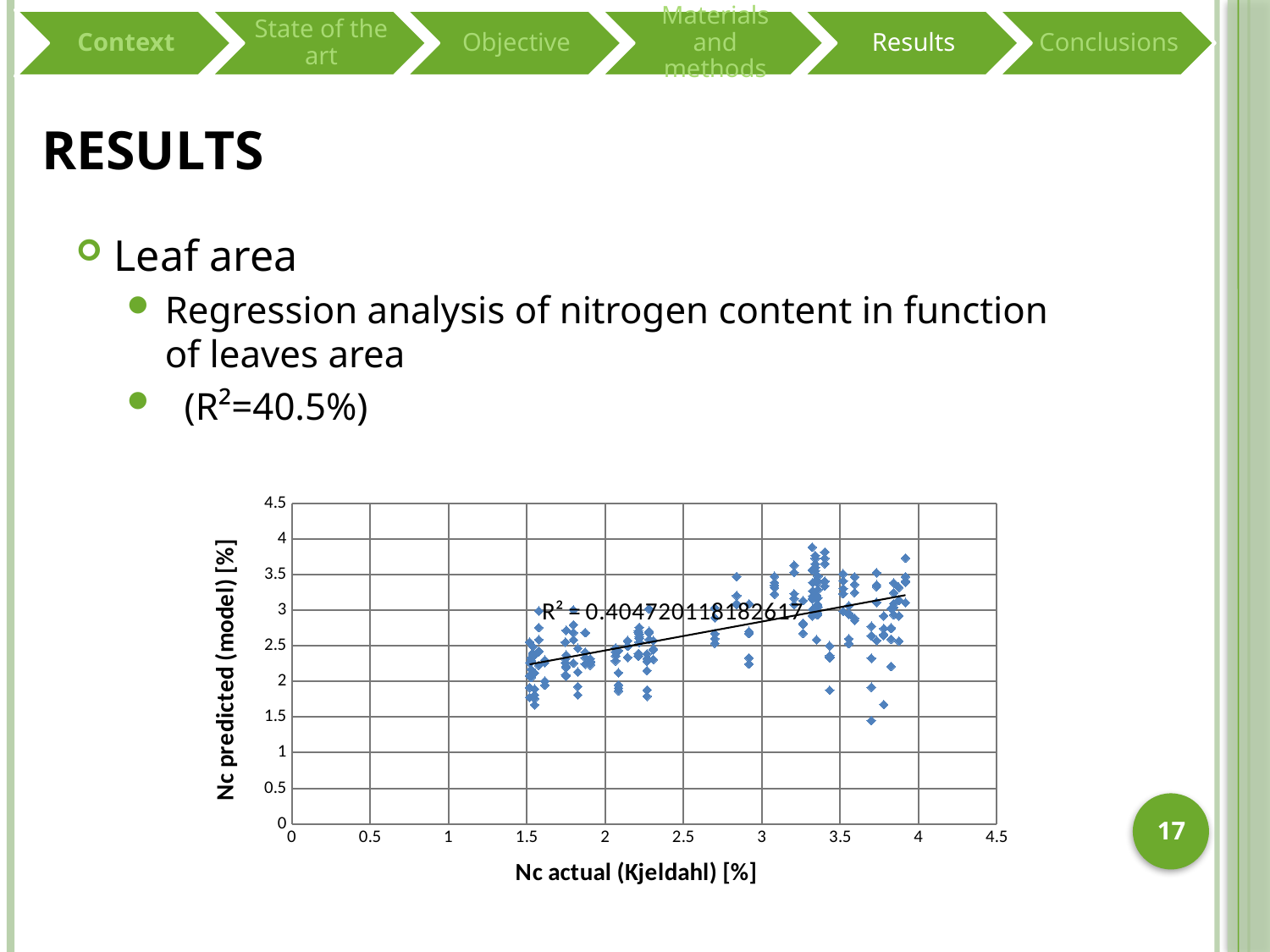
What is the title of the x axis of the chart? Nc actual (Kjeldahl) [%] What kind of chart is shown on the slide? scatter chart What R² value is printed on the chart? R² = 0.404720118182617 Do the plotted values of Nc predicted (model) tend to rise or fall as Nc actual (Kjeldahl) increases? rise What is the highest tick value shown on the y axis of the chart? 4.5 Does the fitted trendline on the chart slope upward or downward from left to right? upward What is the highest tick value shown on the x axis of the chart? 4.5